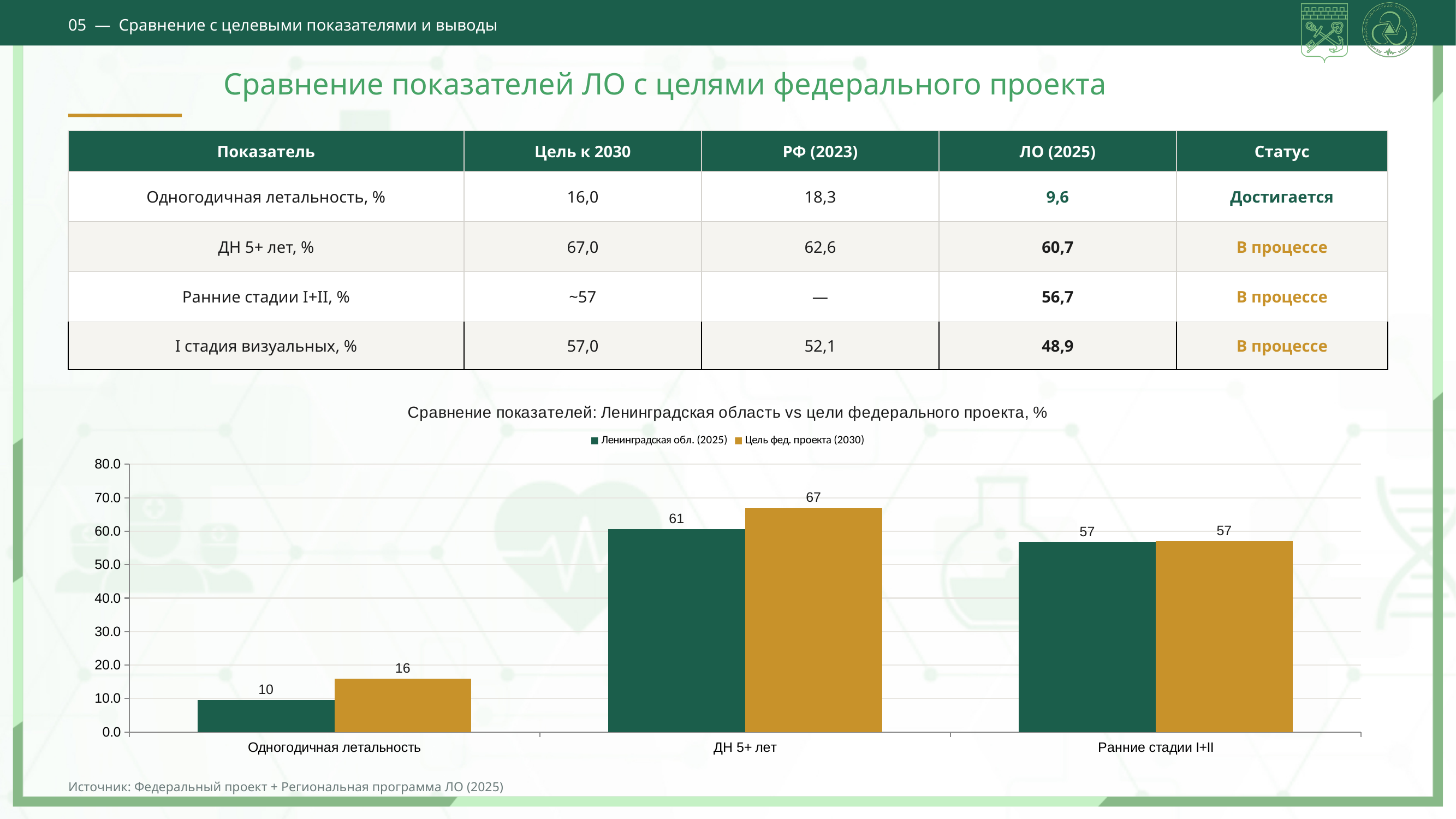
For Одногодичная летальность, which is larger: the Ленинградская обл. (2025) value or the Цель фед. проекта (2030) value? Цель фед. проекта (2030) Which category has the lowest value for the Ленинградская обл. (2025) series? Одногодичная летальность What type of chart is shown on the slide? bar chart What is the value for Ленинградская обл. (2025) in the category Ранние стадии I+II? 57 Is the value for Ленинградская обл. (2025) in ДН 5+ лет greater or less than 50? greater What is the title of the chart? Сравнение показателей: Ленинградская область vs цели федерального проекта, % What is the difference between the Цель фед. проекта (2030) and Ленинградская обл. (2025) values for ДН 5+ лет? 6 How many series does the chart legend list? 2 What is the value for Ленинградская обл. (2025) in the category Одногодичная летальность? 10 Which category has the highest value for the Цель фед. проекта (2030) series? ДН 5+ лет How many categories are shown on the x axis of the chart? 3 What is the value for Цель фед. проекта (2030) in the category ДН 5+ лет? 67